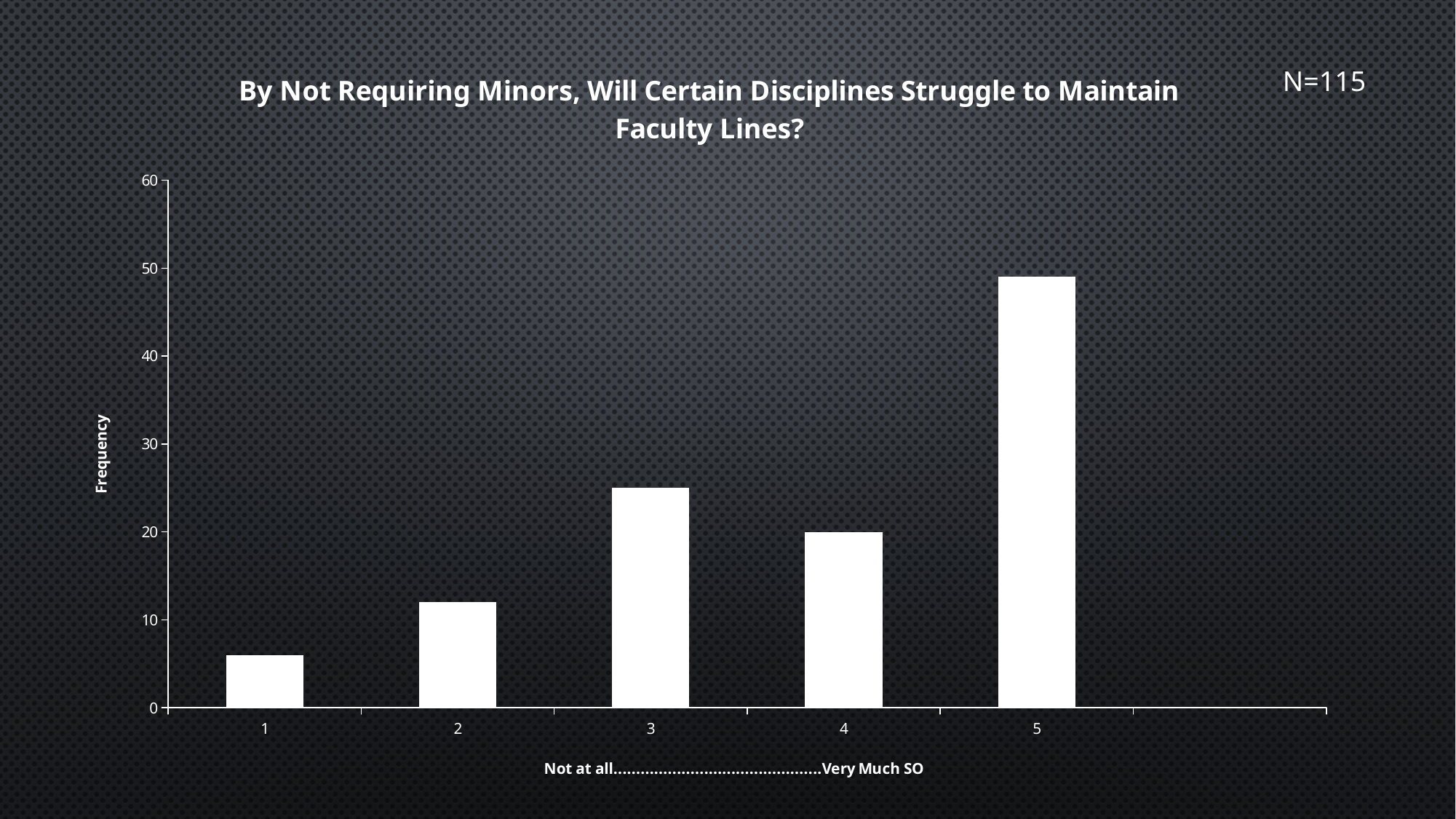
What sample size (N) is shown on the slide? N=115 What is the label of the vertical axis? Frequency Which has a higher frequency, category 3 or category 4? 3 How many bars (categories) are plotted on the chart? 5 Which category has the highest frequency? 5 What is the frequency for category 4? 20 Is the frequency for category 1 greater or less than 10? less Which category has the lowest frequency? 1 What kind of chart is shown on the slide? bar chart Is the frequency for category 5 greater or less than 40? greater Is the frequency for category 2 greater or less than 20? less